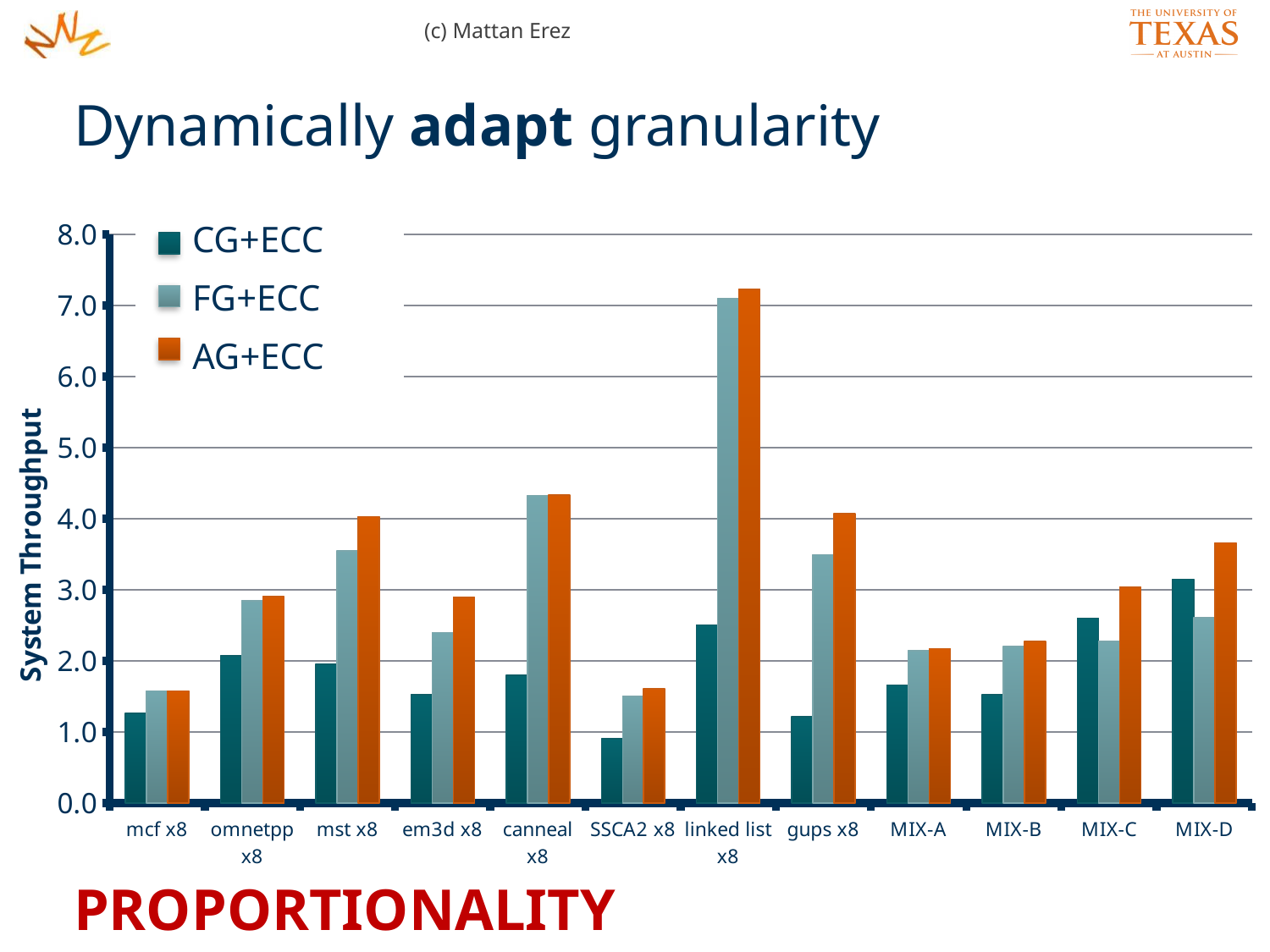
Which category has the highest CG+ECC value? MIX-D Which category has the lowest CG+ECC value? SSCA2 x8 What kind of chart is shown on the slide? bar chart Which category has the highest AG+ECC value? linked list x8 For MIX-D, which is larger: the CG+ECC value or the FG+ECC value? CG+ECC For gups x8, which is larger: the CG+ECC value or the FG+ECC value? FG+ECC How many series does the legend list? 3 Is the CG+ECC value for mcf x8 greater or less than 2.0? less Is the FG+ECC value for mst x8 greater or less than 3.0? greater Is the AG+ECC value for linked list x8 greater or less than 6.0? greater How many categories are shown on the x axis? 12 What is the title of the y axis? System Throughput